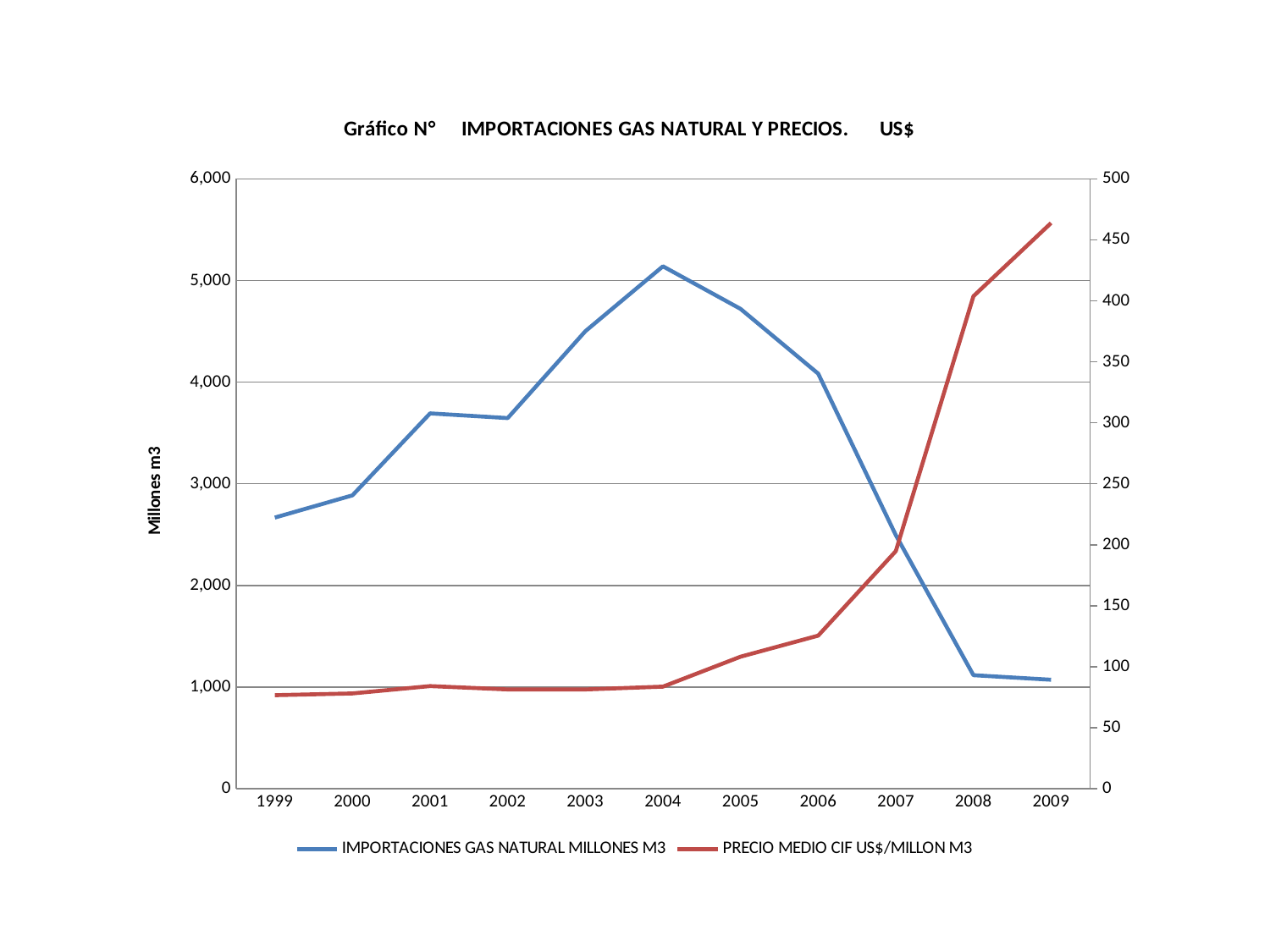
What is the title of the left vertical axis? Millones m3 Is the value for PRECIO MEDIO CIF US$/MILLON M3 in 2009 greater or less than 450? greater Which is larger for IMPORTACIONES GAS NATURAL MILLONES M3: the value in 2003 or the value in 2006? 2003 Is the value for PRECIO MEDIO CIF US$/MILLON M3 in 2007 greater or less than 250? less Is the value for IMPORTACIONES GAS NATURAL MILLONES M3 in 1999 greater or less than 3,000? less In which year does the IMPORTACIONES GAS NATURAL MILLONES M3 series reach its highest value? 2004 How many series does the legend list? 2 How many years are plotted along the x axis? 11 In which year does the PRECIO MEDIO CIF US$/MILLON M3 series reach its highest value? 2009 Does the IMPORTACIONES GAS NATURAL MILLONES M3 series rise or fall from 2004 to 2009? fall What kind of chart is shown on the slide? line chart